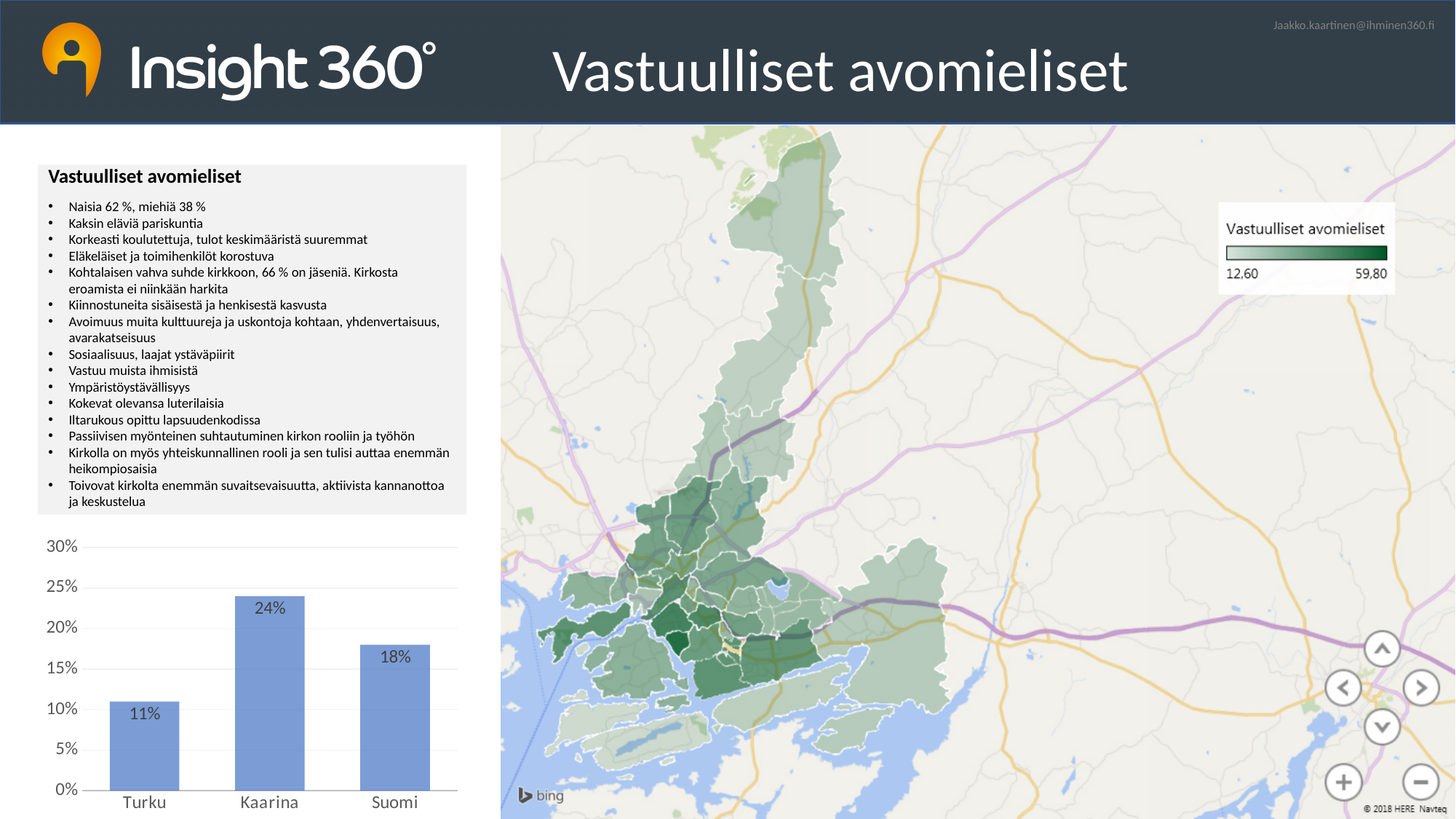
In the bar chart, what is the difference between the values for Kaarina and Turku? 13% On the map legend titled 'Vastuulliset avomieliset', what are the minimum and maximum values of the colour scale? 12,60 and 59,80 In the bar chart, is the value for Suomi greater or less than 20%? less How many categories are shown in the bar chart? 3 In the bar chart, what is the value for Turku? 11% In the bar chart, what is the value for Kaarina? 24% In the bar chart, which category has the lowest value? Turku In the bar chart, which is larger, the value for Suomi or the value for Turku? Suomi What kind of chart is shown at the bottom left of the slide? bar chart In the bar chart, which category has the highest value? Kaarina In the bar chart, what is the value for Suomi? 18% In the bar chart, what is the difference between the values for Kaarina and Suomi? 6%